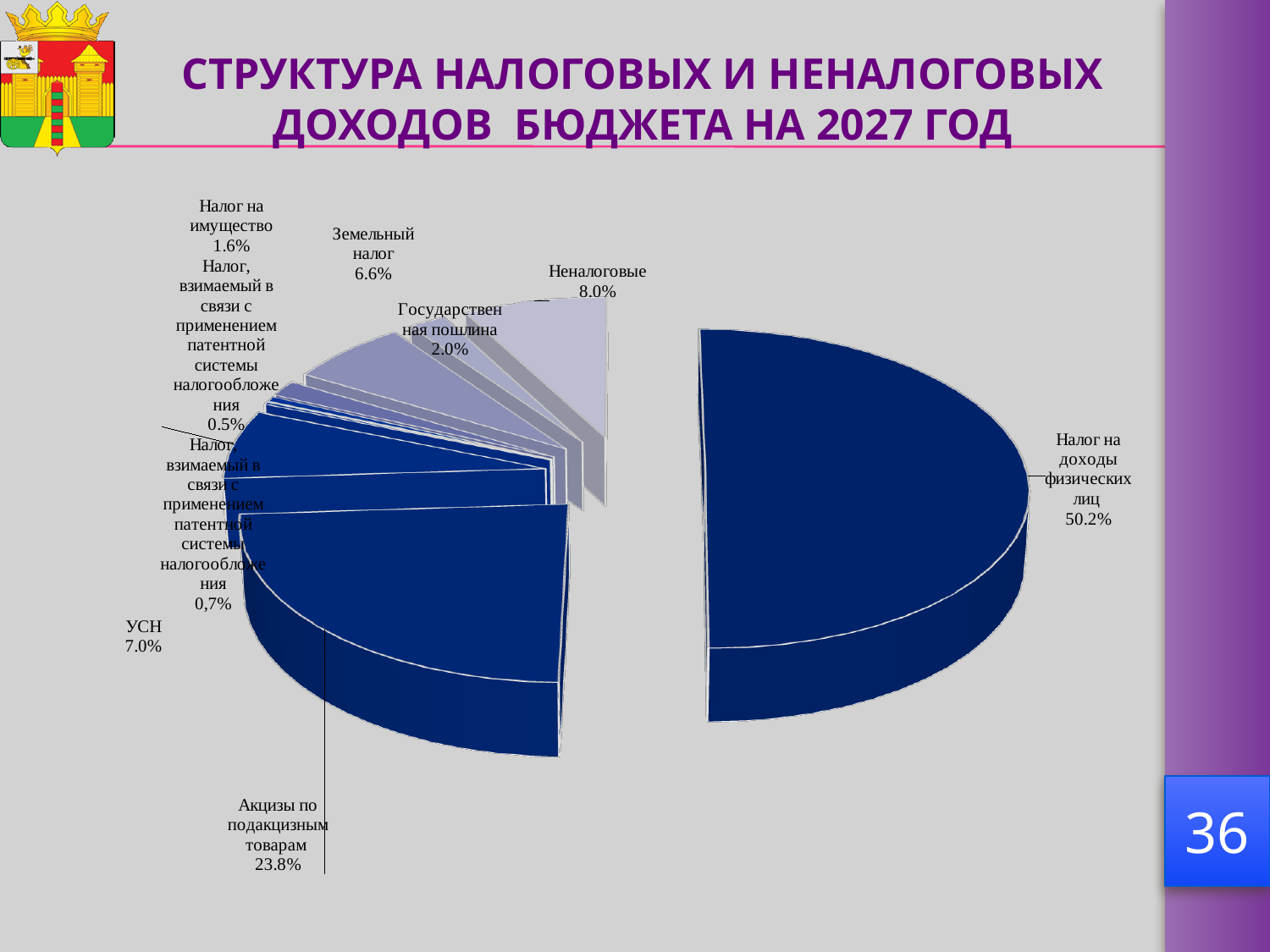
What share is shown for Налог на имущество? 1.6% By how many percentage points does Налог на доходы физических лиц exceed Акцизы по подакцизным товарам? 26.4 What share of the budget revenues is Налог на доходы физических лиц? 50.2% What share is shown for Неналоговые revenues? 8.0% Which category has the largest share of the pie? Налог на доходы физических лиц What share is shown for Земельный налог? 6.6% What share is shown for УСН? 7.0% What share is shown for Акцизы по подакцизным товарам? 23.8% What share is shown for Государственная пошлина? 2.0% What is the title of the slide containing the chart? СТРУКТУРА НАЛОГОВЫХ И НЕНАЛОГОВЫХ ДОХОДОВ БЮДЖЕТА НА 2027 ГОД What kind of chart is shown on the slide? pie chart Which is larger, the share for УСН or the share for Земельный налог? УСН